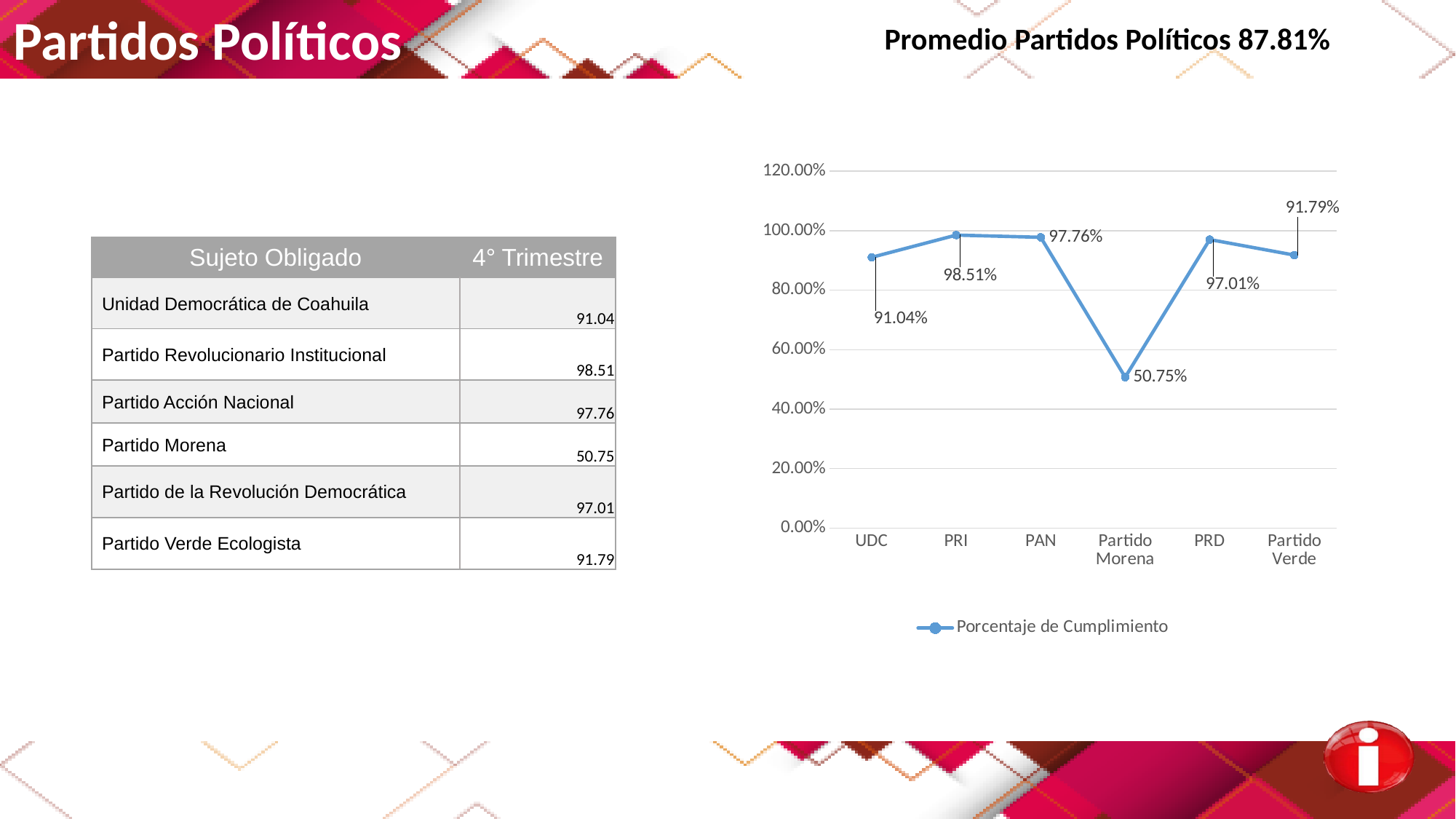
Which category has the highest value in the chart? PRI What is the difference between the values for PRI and Partido Morena? 47.76% What is the value for Partido Morena in the chart? 50.75% What is the value for PRI in the chart? 98.51% What is the difference between the values for Partido Verde and UDC? 0.75% Which category has the lowest value in the chart? Partido Morena What kind of chart is shown on the slide? line chart Which is larger, the value for PAN or the value for PRD? PAN How many categories are plotted on the x axis of the chart? 6 What is the value for PRD in the chart? 97.01% Is the value for Partido Morena greater or less than 60.00%? less What series name does the chart legend show? Porcentaje de Cumplimiento